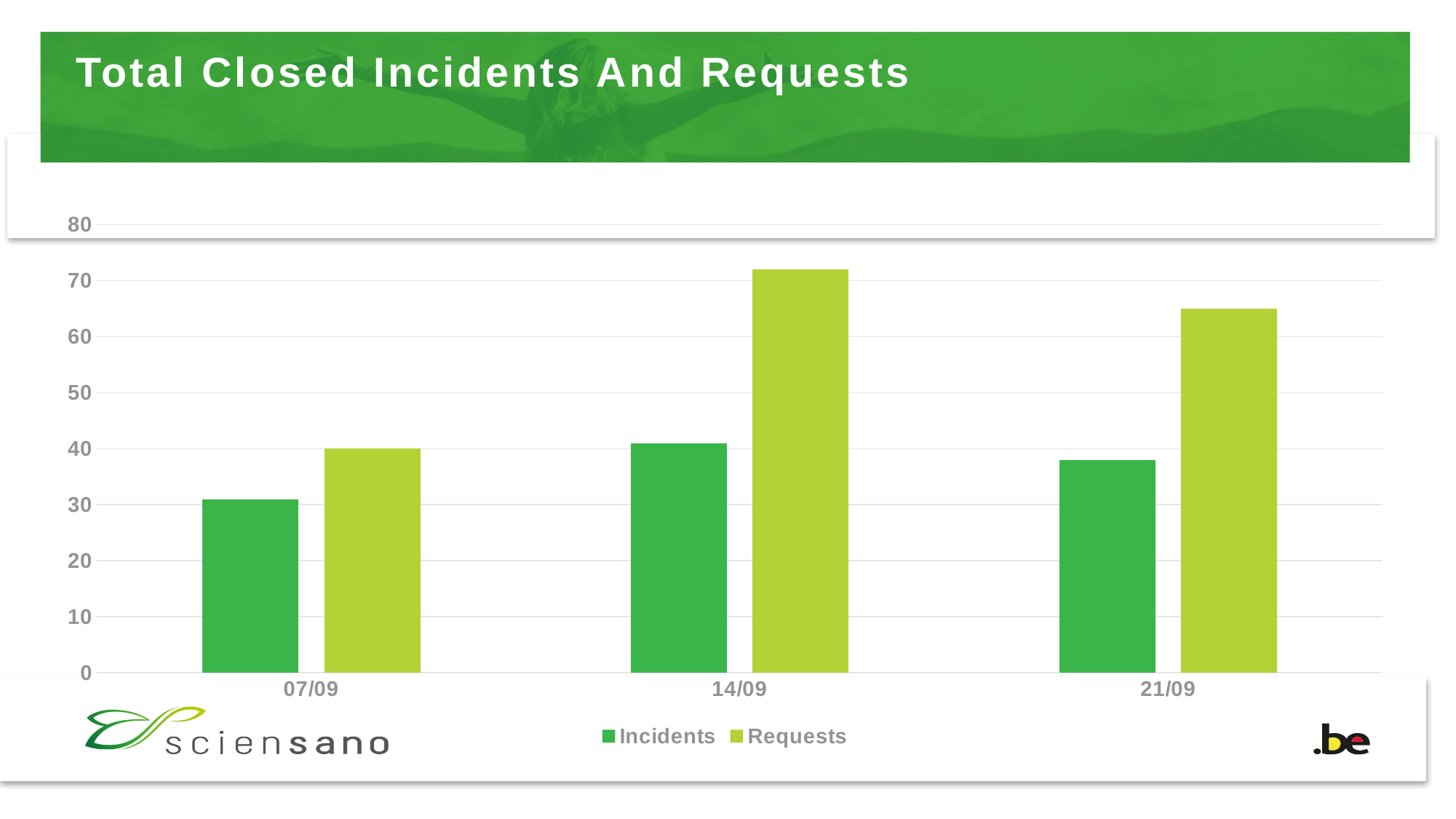
How many dates are shown on the x axis? 3 Is the value for Incidents on 07/09 greater or less than 40? less On which date is the Incidents bar lowest? 07/09 Is the value for Requests on 21/09 greater or less than 60? greater What kind of chart is shown on the slide? bar chart What is the title of the chart? Total Closed Incidents And Requests Is the value for Requests on 14/09 greater or less than 60? greater On 14/09, which is larger, Incidents or Requests? Requests How many series does the legend list? 2 On which date is the Requests bar highest? 14/09 Does the Requests value rise or fall from 07/09 to 14/09? rise